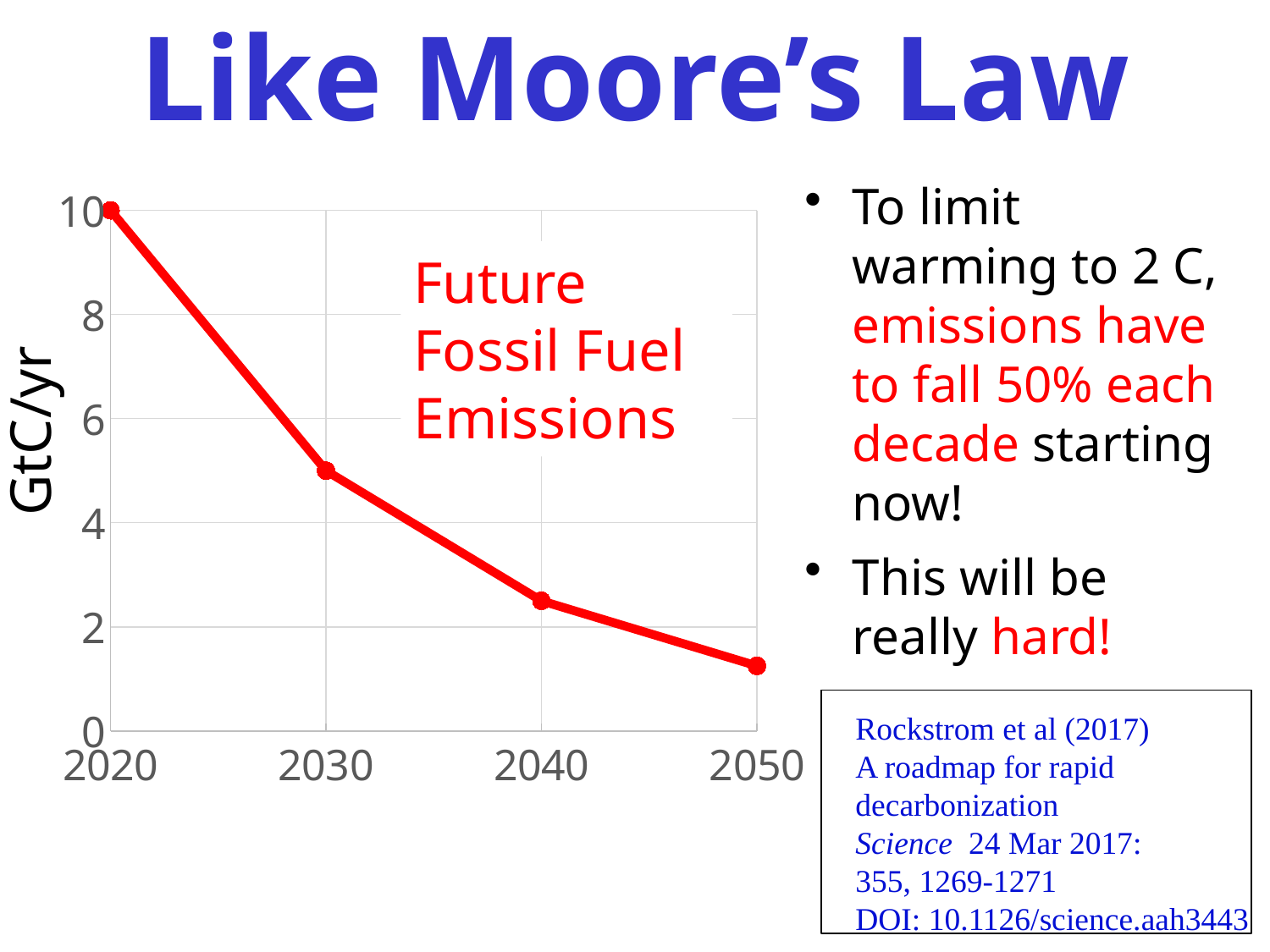
Which year has the highest plotted value? 2020 What is the label on the vertical axis of the chart? GtC/yr What is the value plotted for 2020? 10 Is the value for 2040 greater or less than 4? less What kind of chart is shown on the slide? line chart Is the value for 2030 greater or less than 6? less Do the plotted values rise or fall from 2020 to 2050? fall How many data points are plotted on the line? 4 Is the value for 2050 greater or less than 2? less Which year has the lowest plotted value? 2050 Which year has the larger plotted value, 2030 or 2040? 2030